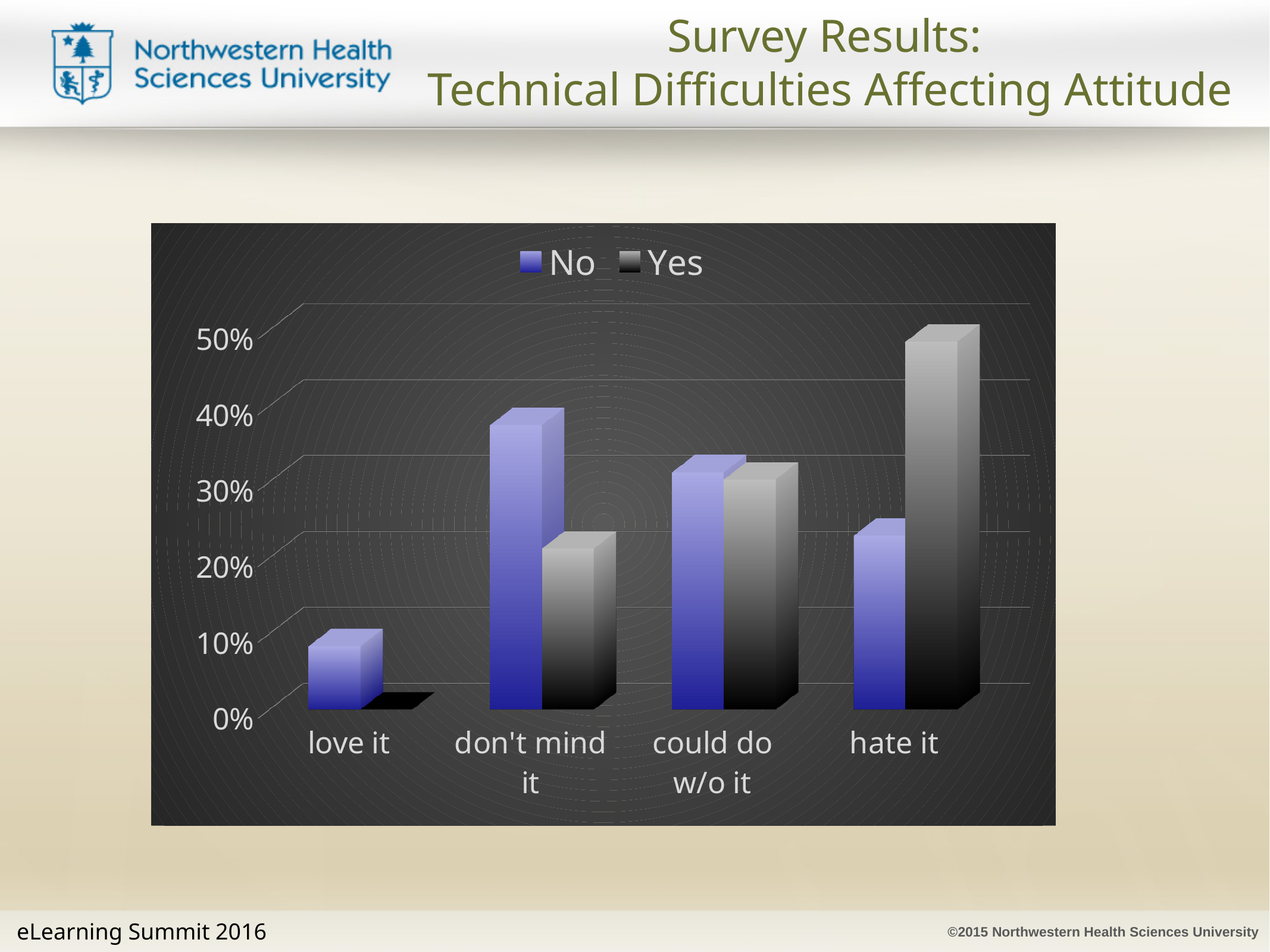
How many categories are shown on the x axis? 4 Is the No value for "don't mind it" greater or less than 30%? greater What kind of chart is shown on the slide? bar chart How many series does the legend list? 2 Is the Yes value for "hate it" greater or less than 40%? greater Which category has the highest value for the No series? don't mind it Which category has the highest value for the Yes series? hate it Which category has the lowest value for the No series? love it What are the two entries in the chart legend? No and Yes Is the Yes value for "don't mind it" greater or less than 30%? less For the category "don't mind it", which series has the larger value, No or Yes? No For the category "hate it", which series has the larger value, No or Yes? Yes